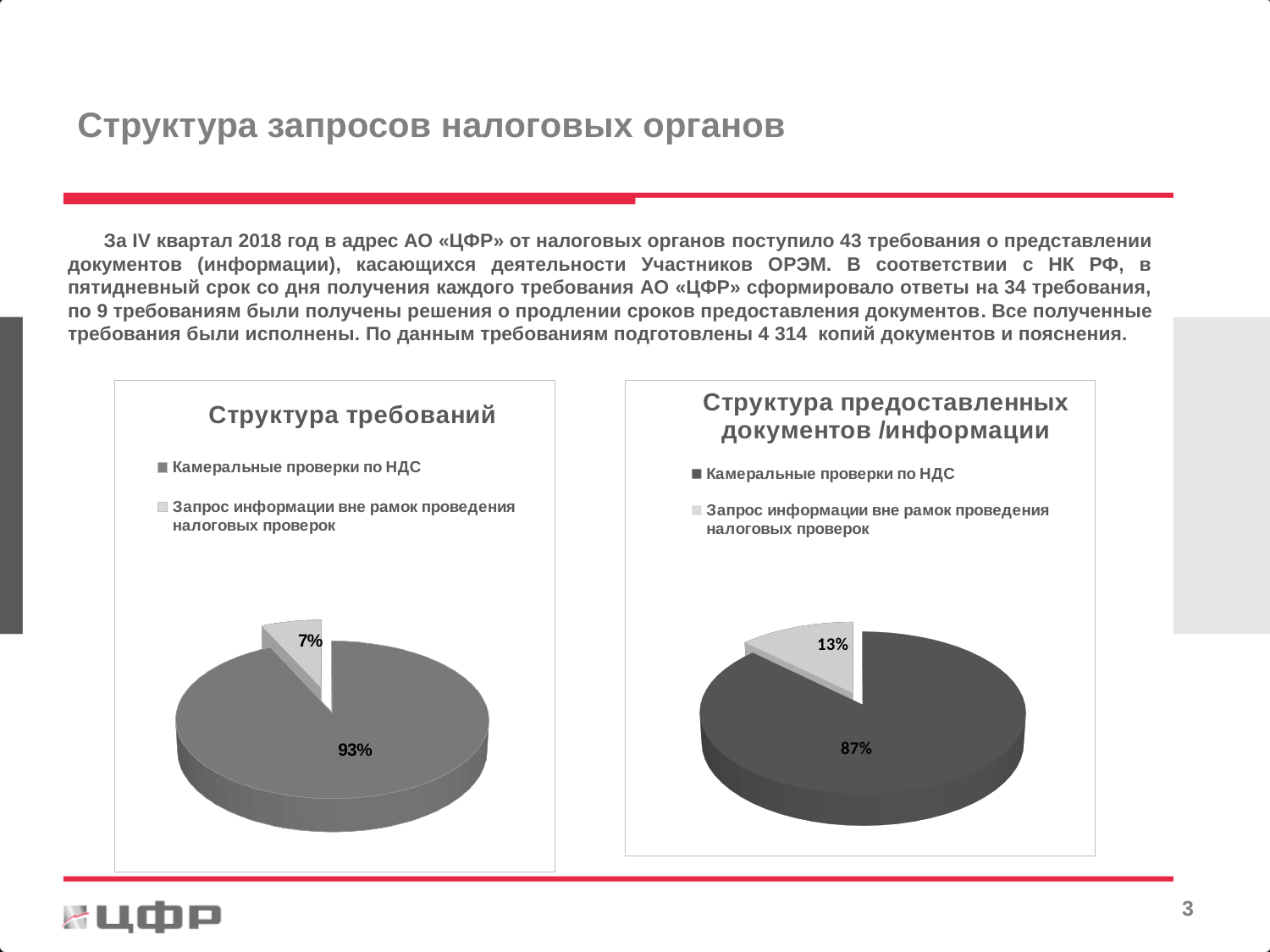
In the chart titled "Структура требований", what share is shown for "Запрос информации вне рамок проведения налоговых проверок"? 7% In the chart titled "Структура требований", what share is shown for "Камеральные проверки по НДС"? 93% What is the title of the chart on the right side of the slide? Структура предоставленных документов /информации Which is larger: the share of "Запрос информации вне рамок проведения налоговых проверок" in the left chart or in the right chart? the right chart In the chart titled "Структура требований", which category has the largest slice? Камеральные проверки по НДС What type of chart is the chart titled "Структура требований"? pie chart In the chart titled "Структура требований", what is the difference in percentage points between the two slices? 86 In the chart titled "Структура предоставленных документов /информации", what share is shown for "Камеральные проверки по НДС"? 87% In the chart titled "Структура предоставленных документов /информации", what is the difference in percentage points between the two slices? 74 In the chart titled "Структура предоставленных документов /информации", which category has the smallest slice? Запрос информации вне рамок проведения налоговых проверок How many categories does the legend of the chart titled "Структура предоставленных документов /информации" list? 2